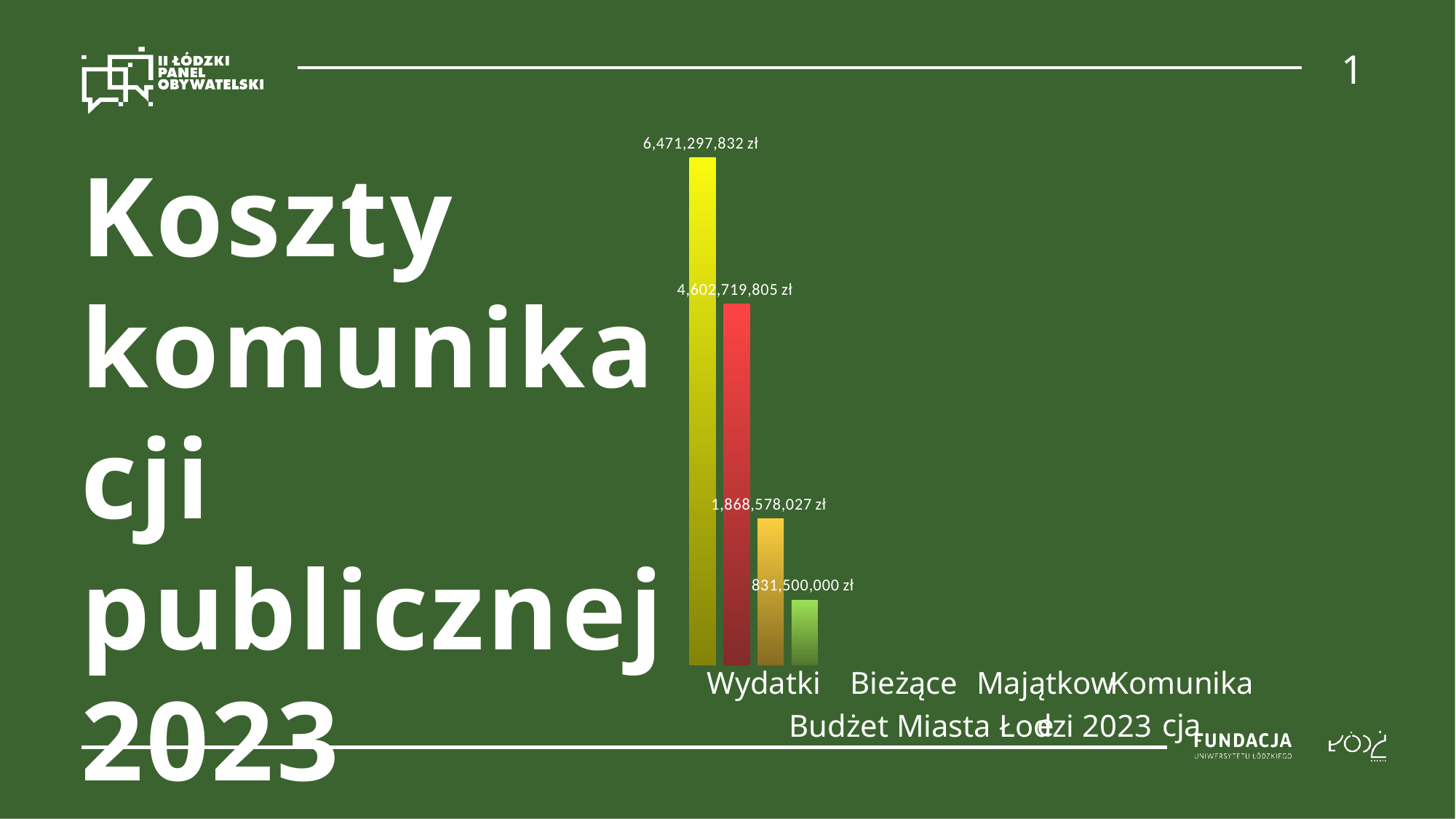
What is the value of the Majątkowe bar? 1,868,578,027 zł What is the value of the Komunikacja bar? 831,500,000 zł Which is larger, the Bieżące value or the Majątkowe value? Bieżące What is the value of the Wydatki bar? 6,471,297,832 zł Which category has the lowest value? Komunikacja What is the value of the Bieżące bar? 4,602,719,805 zł What is the difference between the Wydatki and Bieżące values? 1,868,578,027 zł What kind of chart is shown on the slide? Bar chart Which category has the highest value? Wydatki What colour is the Komunikacja bar? Green What is the difference between the Majątkowe and Komunikacja values? 1,037,078,027 zł How many bars are shown in the chart? 4